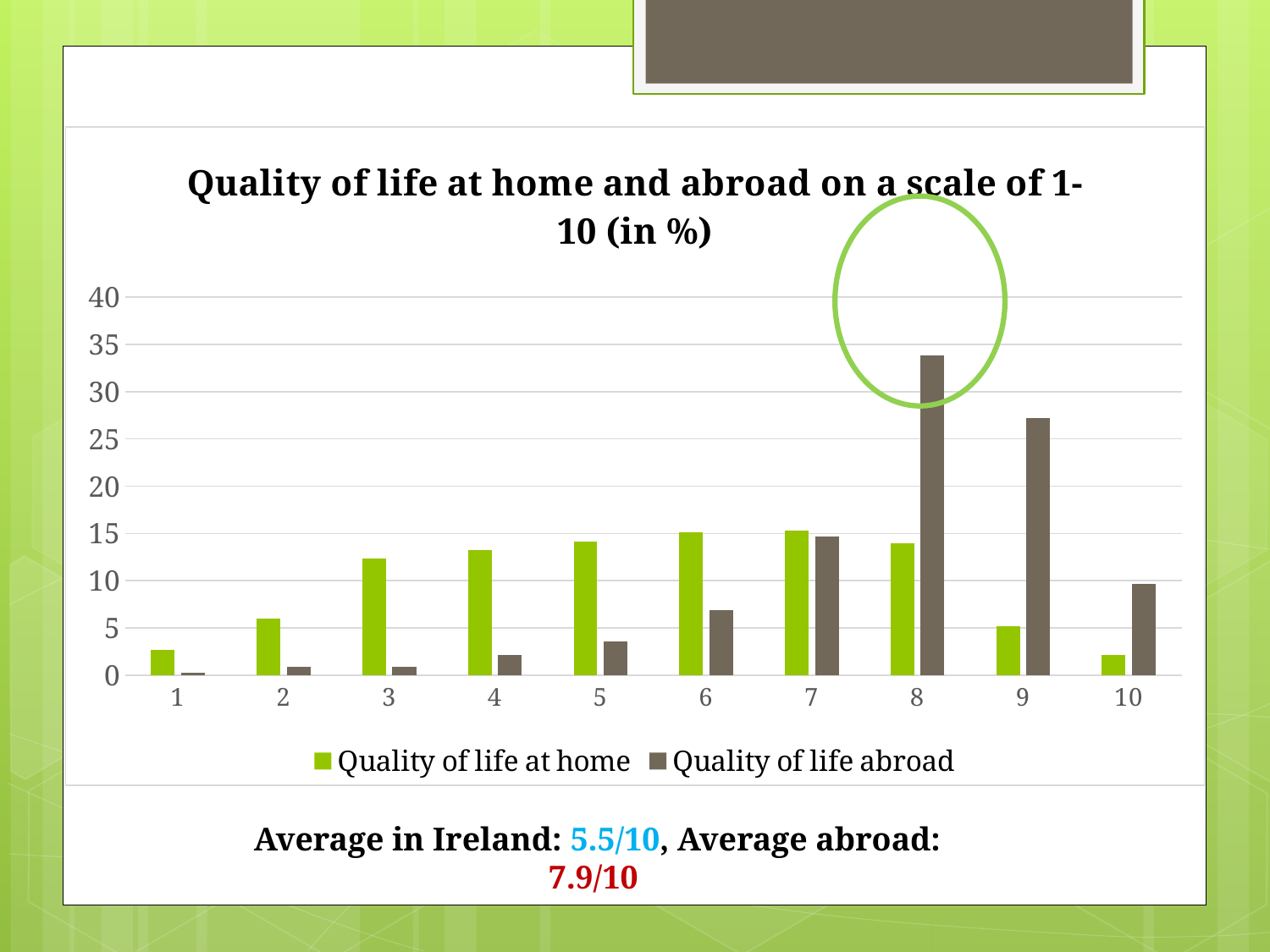
At scale value 3, which series has the larger value: 'Quality of life at home' or 'Quality of life abroad'? Quality of life at home Is the 'Quality of life abroad' value at 8 greater or less than 30? greater For which scale value is the 'Quality of life abroad' bar highest? 8 How many series does the legend list? 2 Is the 'Quality of life at home' value at 3 greater or less than 10? greater At scale value 8, which series has the larger value: 'Quality of life at home' or 'Quality of life abroad'? Quality of life abroad What is the title of the chart? Quality of life at home and abroad on a scale of 1-10 (in %) Do the 'Quality of life abroad' values rise or fall from scale value 1 to 8? rise Is the 'Quality of life abroad' value at 9 greater or less than 25? greater How many categories are shown on the x axis? 10 What kind of chart is shown on the slide? bar chart